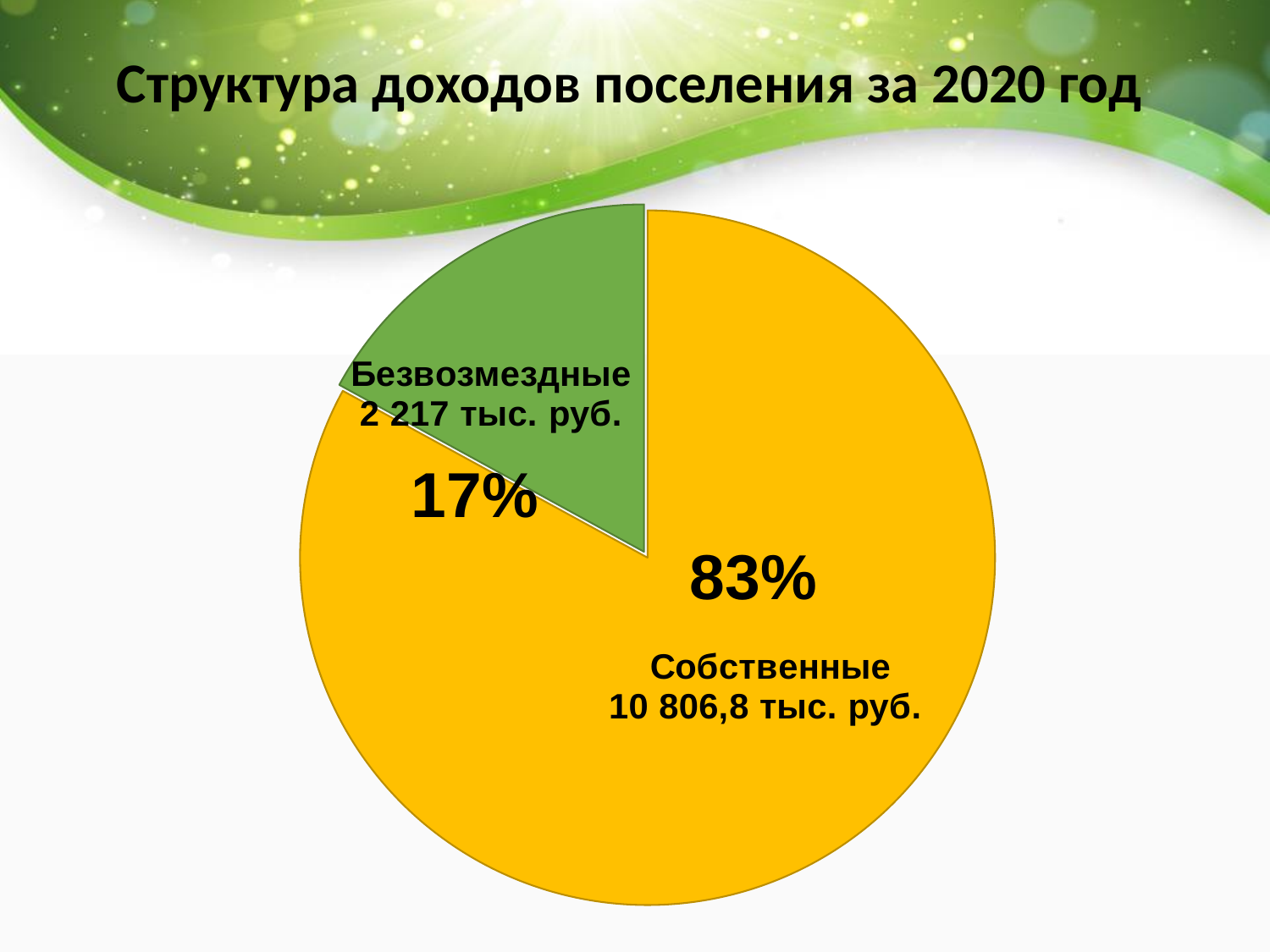
Which category has the largest slice of the pie? Собственные What is the difference between the values for Собственные and Безвозмездные? 8 589,8 тыс. руб. Which category has the smallest slice of the pie? Безвозмездные What is the value for Собственные? 10 806,8 тыс. руб. What kind of chart is shown on the slide? Pie chart Which is larger, Собственные or Безвозмездные? Собственные What is the title of the chart on the slide? Структура доходов поселения за 2020 год What colour is the Безвозмездные slice? Green What share of the pie does the Собственные slice represent? 83% What is the value for Безвозмездные? 2 217 тыс. руб. How many slices does the pie chart have? 2 What share of the pie does the Безвозмездные slice represent? 17%